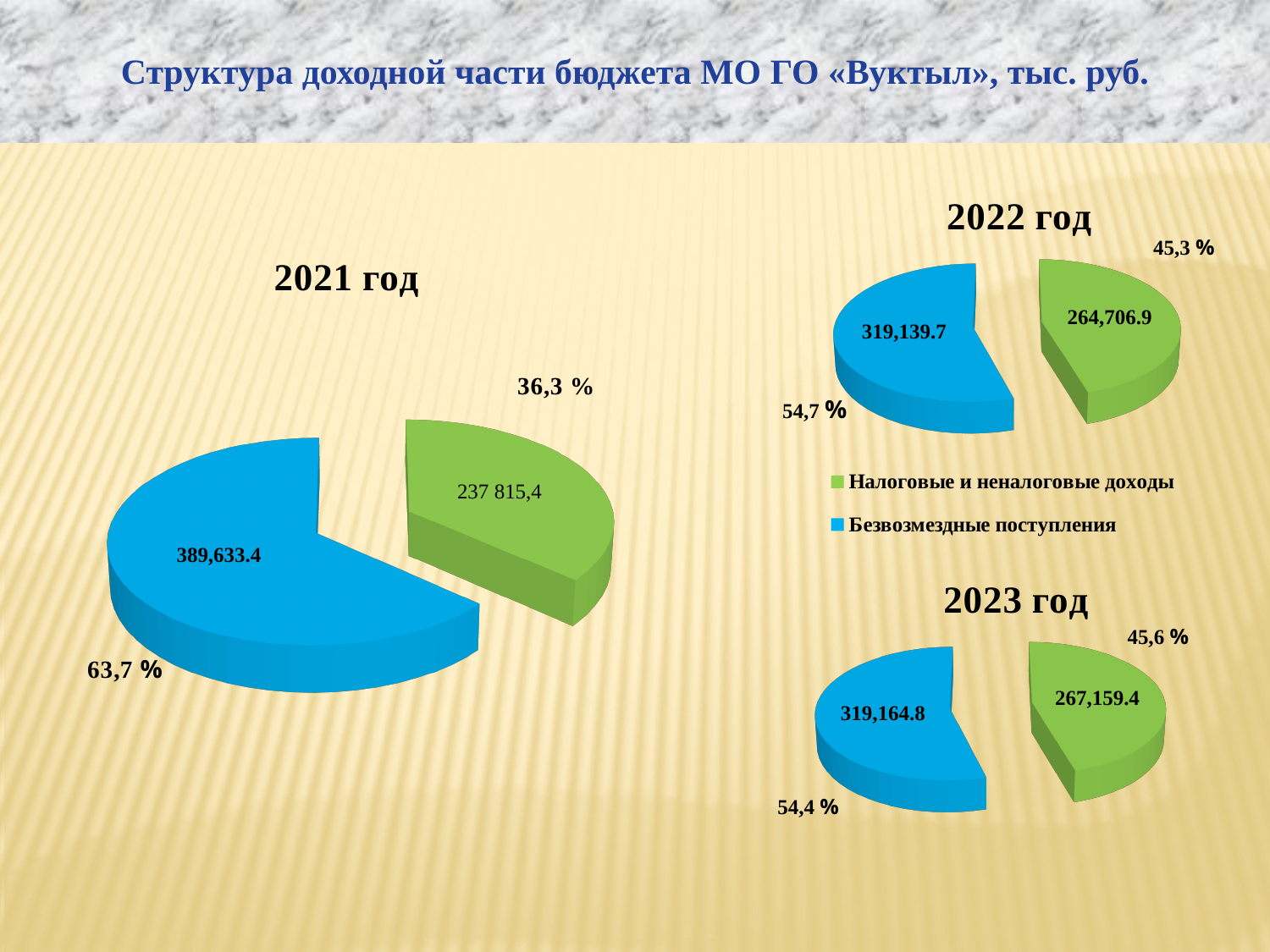
In the 2023 год pie chart, what value is shown for Безвозмездные поступления? 319,164.8 In the 2022 год pie chart, what value is shown for Налоговые и неналоговые доходы? 264,706.9 What kind of chart is used for 2021 год, 2022 год and 2023 год? Pie chart In the 2021 год pie chart, which category is the smallest? Налоговые и неналоговые доходы In the 2021 год pie chart, what value is shown for Налоговые и неналоговые доходы? 237 815,4 In the 2021 год pie chart, what share of the pie is Безвозмездные поступления? 63,7 % In the 2021 год pie chart, what value is shown for Безвозмездные поступления? 389,633.4 In the 2023 год pie chart, which is larger: Налоговые и неналоговые доходы or Безвозмездные поступления? Безвозмездные поступления How many categories does the legend list for the pie charts? 2 In the 2023 год pie chart, what share of the pie is Безвозмездные поступления? 54,4 % In the 2022 год pie chart, what share of the pie is Налоговые и неналоговые доходы? 45,3 % In the 2022 год pie chart, which category is the largest? Безвозмездные поступления